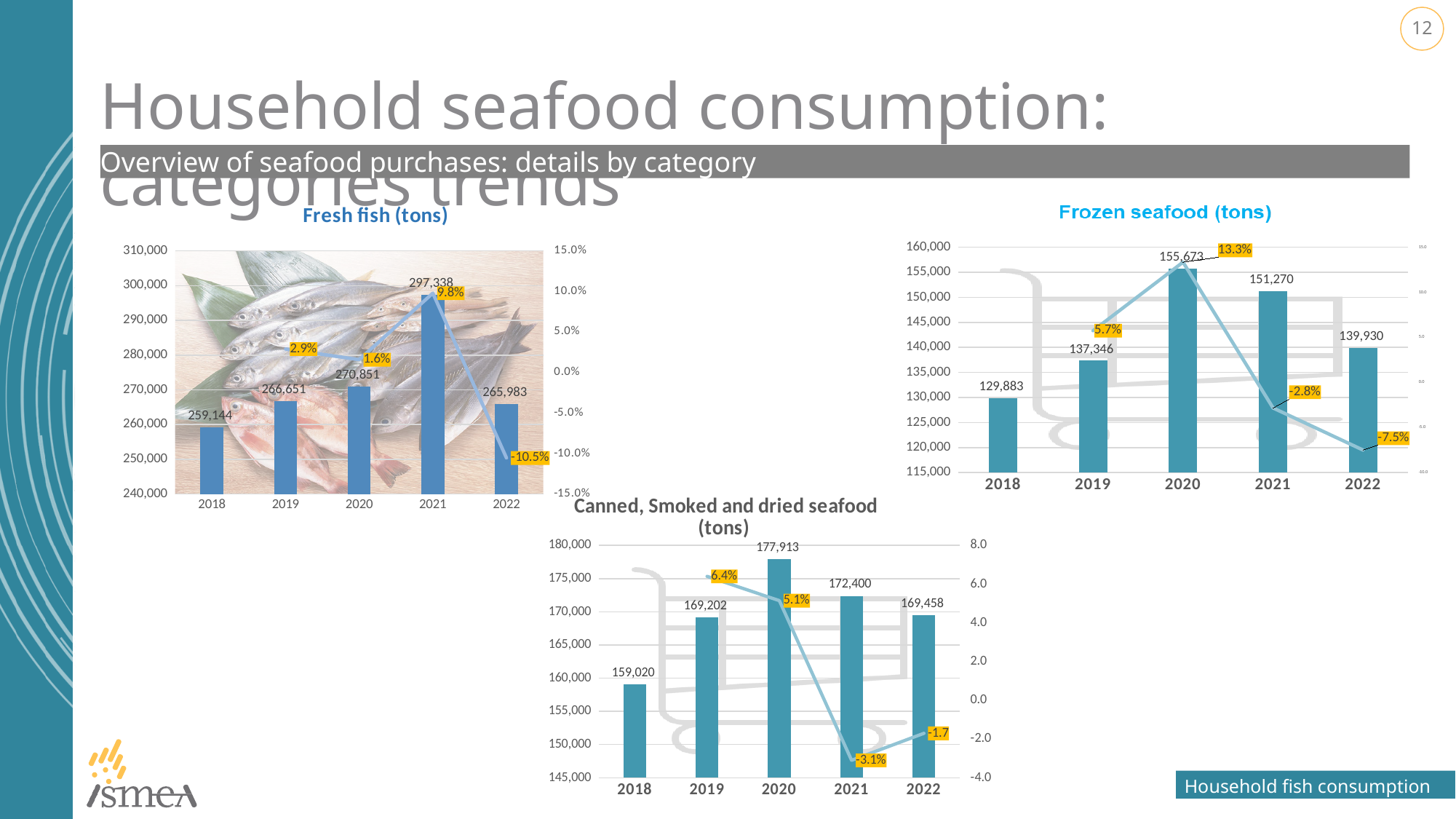
How many years are shown on the x axis of the Fresh fish (tons) chart? 5 In the Canned, Smoked and dried seafood (tons) chart, what is the value for 2018? 159,020 In the Fresh fish (tons) chart, what percentage change is labelled for 2022? -10.5% In the Frozen seafood (tons) chart, what is the difference between the 2020 and 2018 values? 25,790 In the Fresh fish (tons) chart, which year has the lowest bar value? 2018 What type of chart is used for the bar values in the Frozen seafood (tons) chart? Bar chart In the Canned, Smoked and dried seafood (tons) chart, which is larger, the value for 2021 or the value for 2022? 2021 In the Frozen seafood (tons) chart, what is the value for 2020? 155,673 In the Canned, Smoked and dried seafood (tons) chart, what percentage change is labelled for 2021? -3.1% In the Frozen seafood (tons) chart, which year has the highest bar value? 2020 In the Frozen seafood (tons) chart, what percentage change is labelled for 2019? 5.7% In the Fresh fish (tons) chart, what is the value for 2021? 297,338